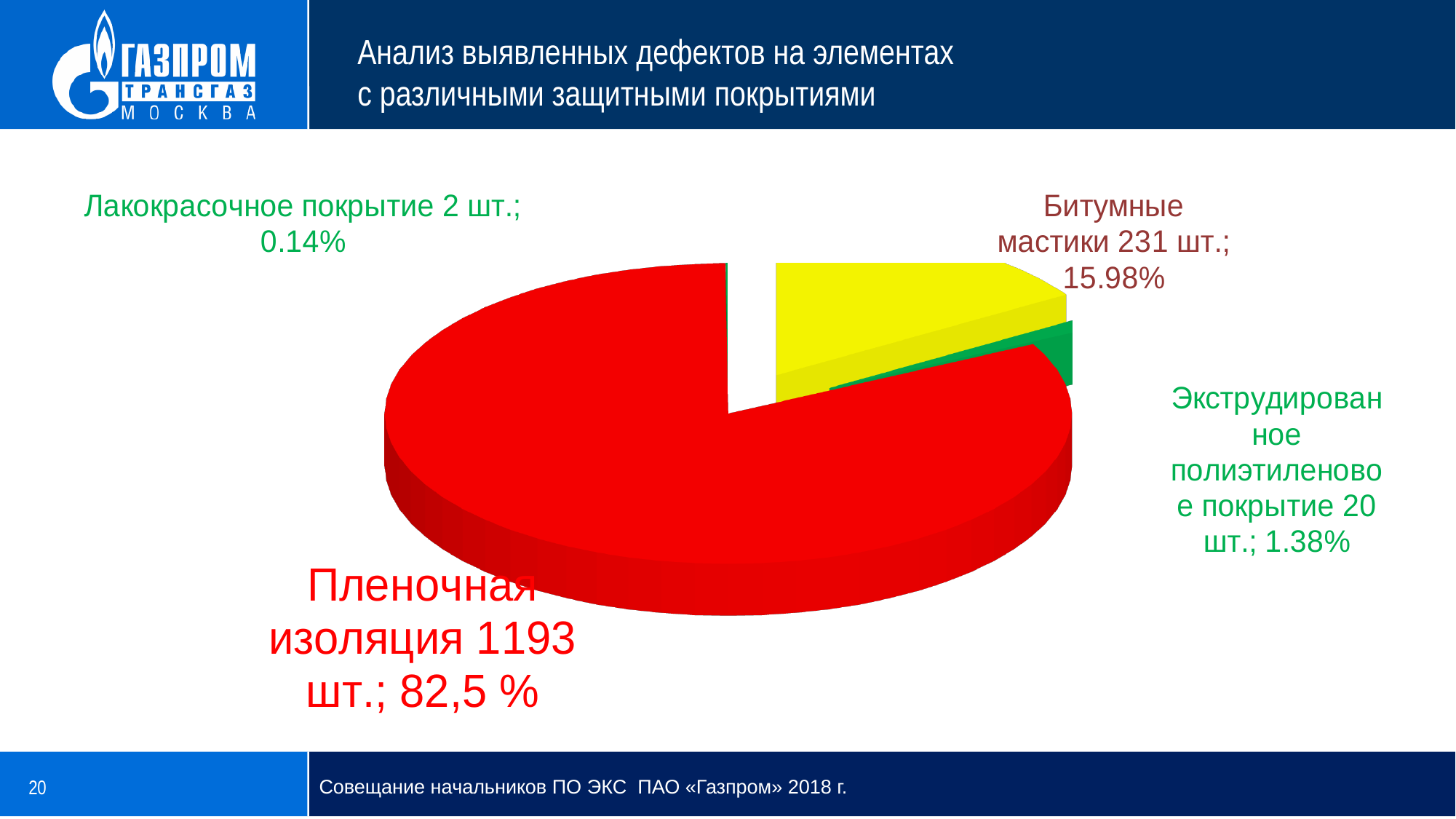
How many defects (шт.) are shown for Битумные мастики? 231 шт. Which category has the largest slice of the pie? Пленочная изоляция Which category has the smallest slice of the pie? Лакокрасочное покрытие How many defects (шт.) are shown for Лакокрасочное покрытие? 2 шт. What share of the pie does Пленочная изоляция account for? 82,5 % What kind of chart is shown on the slide? Pie chart What share of the pie does Битумные мастики account for? 15.98% How many defects (шт.) are shown for Экструдированное полиэтиленовое покрытие? 20 шт. How many slices does the pie chart have? 4 How many defects (шт.) are shown for Пленочная изоляция? 1193 шт. What colour is the slice for Битумные мастики? Yellow What is the difference in defect count between Битумные мастики and Экструдированное полиэтиленовое покрытие? 211 шт.